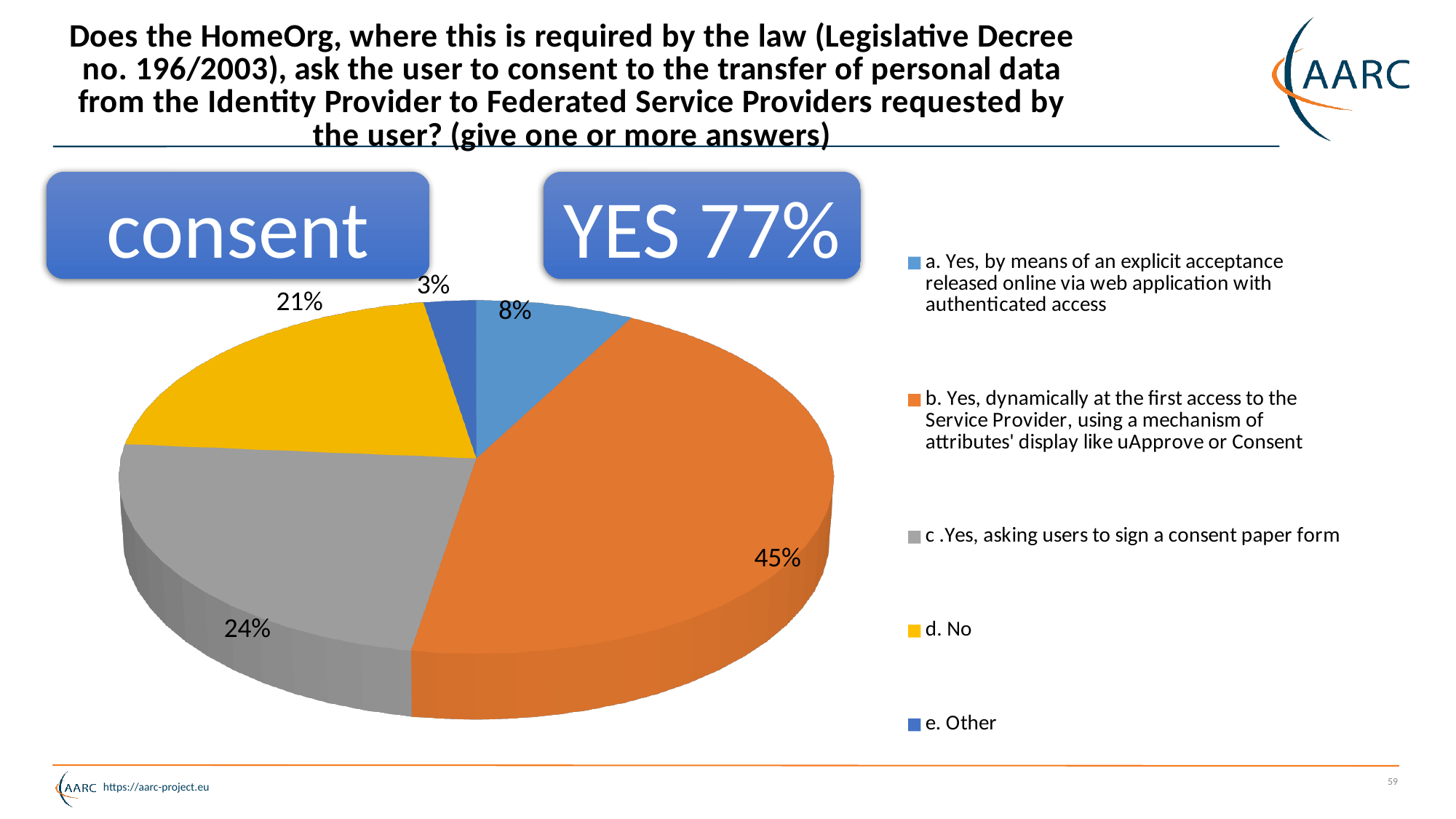
What percentage is shown for "e. Other"? 3% What kind of chart is shown on the slide? pie chart What colour is the slice for "d. No"? yellow How many slices does the pie chart have? 5 What percentage is shown for "a. Yes, by means of an explicit acceptance released online via web application with authenticated access"? 8% Which legend entry has the largest slice of the pie? b. Yes, dynamically at the first access to the Service Provider, using a mechanism of attributes' display like uApprove or Consent Which legend entry has the smallest slice of the pie? e. Other What is the difference in percentage points between the "c. Yes, asking users to sign a consent paper form" slice and the "d. No" slice? 3 What percentage is shown for "c. Yes, asking users to sign a consent paper form"? 24% Which slice is larger: "a. Yes, by means of an explicit acceptance released online via web application with authenticated access" or "d. No"? d. No What percentage is shown for "d. No"? 21% What percentage is shown for "b. Yes, dynamically at the first access to the Service Provider, using a mechanism of attributes' display like uApprove or Consent"? 45%